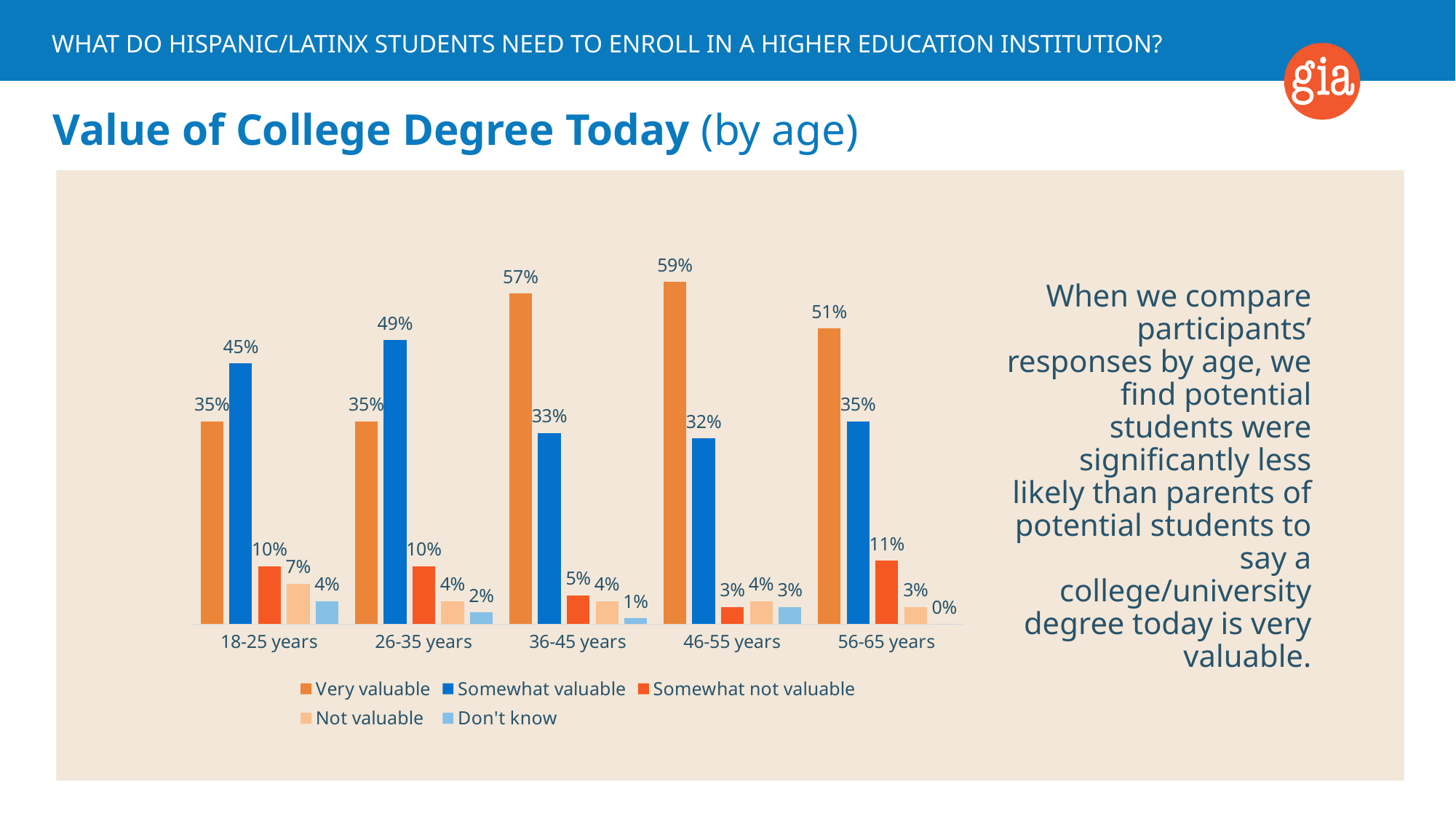
What is the title of the chart? Value of College Degree Today (by age) Which is larger for the 18-25 years group: Very valuable or Somewhat valuable? Somewhat valuable What is the difference between the Very valuable values for 36-45 years and 18-25 years? 22% How many series does the legend list? 5 Which age group has the highest Very valuable value? 46-55 years Does the Somewhat valuable value rise or fall from 26-35 years to 46-55 years? Fall What kind of chart is shown on the slide? Bar chart What is the Don't know value for the 56-65 years group? 0% Which age group has the lowest Somewhat valuable value? 46-55 years What percentage of 46-55 year olds said a college degree is very valuable? 59% How many age groups are shown on the x axis? 5 What is the Somewhat valuable value for the 26-35 years group? 49%